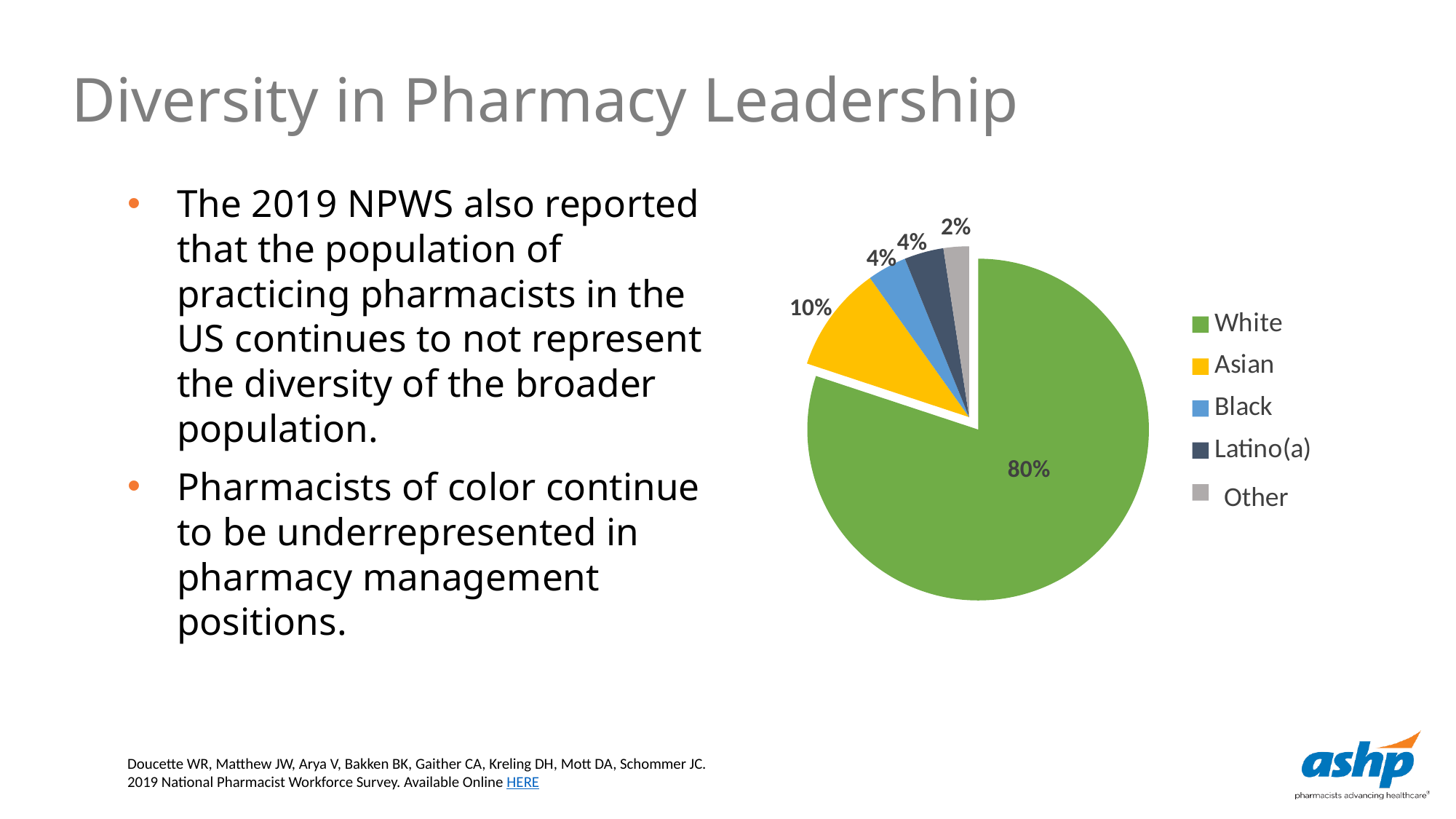
What is the difference in percentage points between White and Asian? 70 Which category has the smallest slice of the pie? Other How many categories does the pie chart show? 5 What colour is the slice for Asian? Yellow What is the difference in percentage points between Asian and Other? 8 What percentage is shown for Asian? 10% What kind of chart is shown on the slide? Pie chart What percentage is shown for Other? 2% Which category has the largest slice of the pie? White What percentage is shown for Black? 4% What share of the pie does White represent? 80% Which is larger, the share for Asian or the share for Latino(a)? Asian